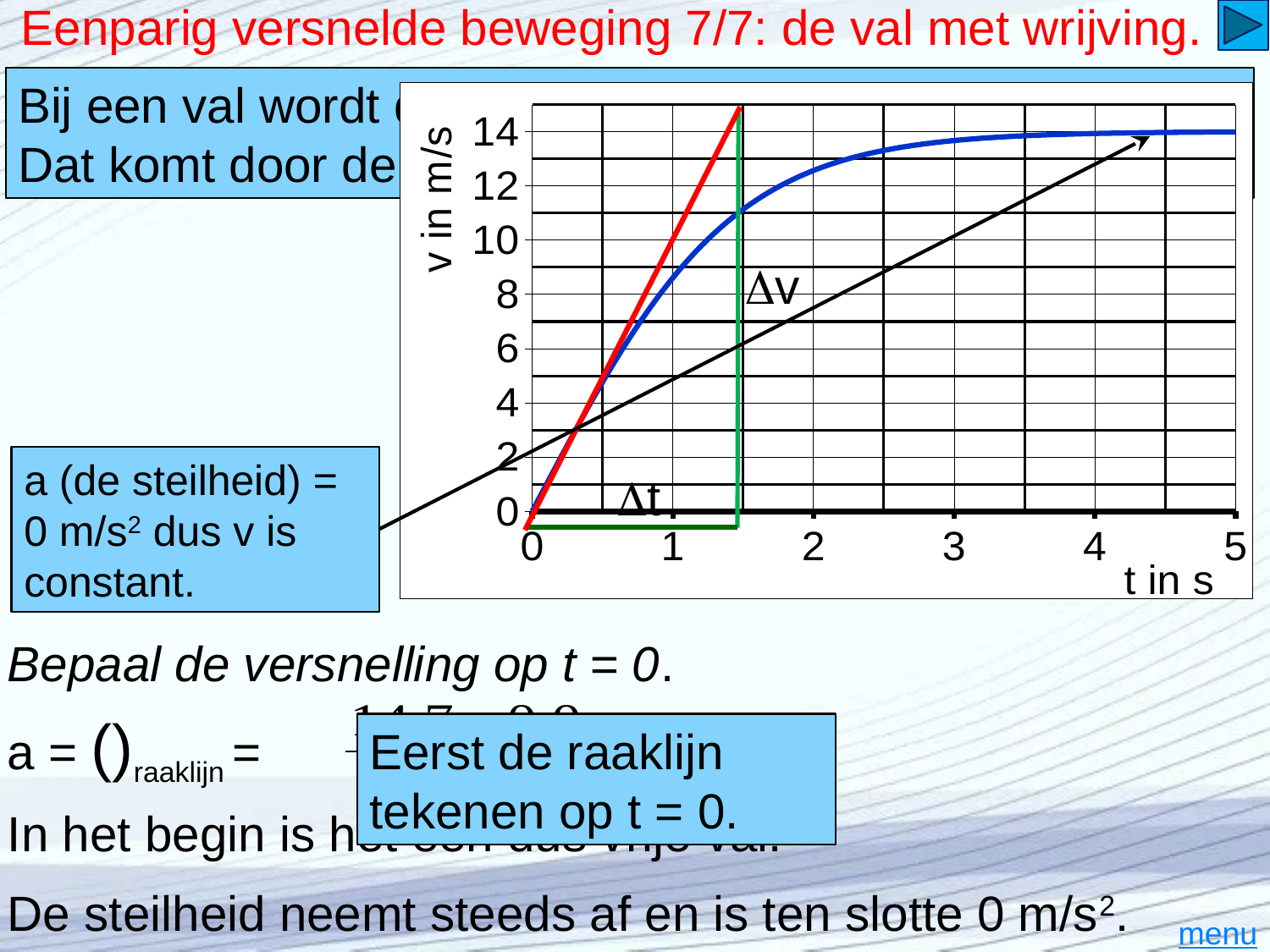
What is the highest value labelled on the vertical axis? 14 What kind of chart is shown on the slide? line chart What is the label of the vertical axis of the chart? v in m/s Is the value of the blue curve at t = 3 s greater or less than 12 m/s? greater Is the value of the blue curve at t = 4 s greater or less than 10 m/s? greater What is the highest value labelled on the horizontal axis? 5 Is the value of the blue curve at t = 2 s greater or less than 10 m/s? greater Does the blue curve rise or fall as t increases? rise How many labelled tick values are there on the horizontal axis? 6